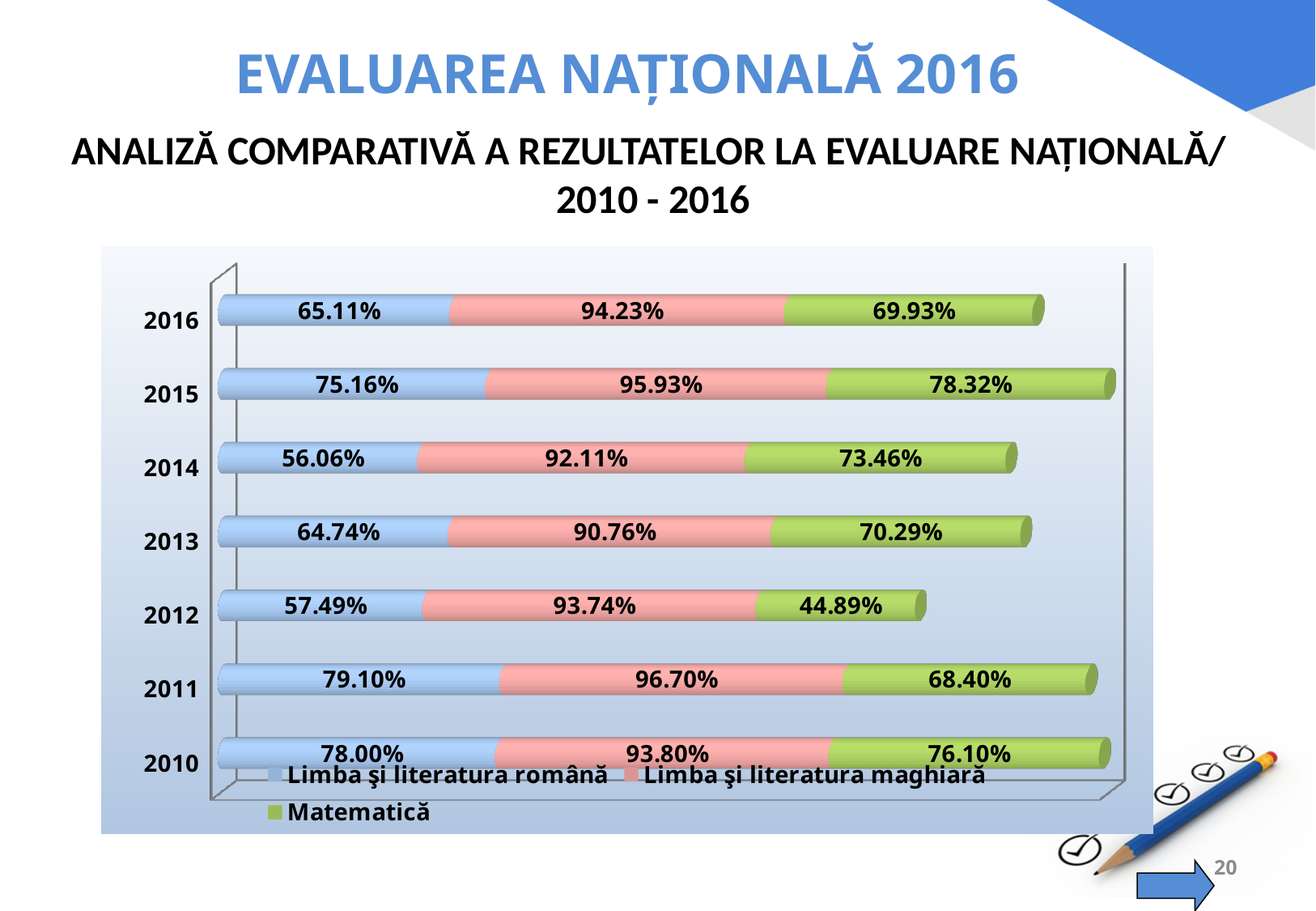
What kind of chart is shown on the slide? Stacked bar chart What is the value for Limba şi literatura română in 2016? 65.11% What is the value for Matematică in 2012? 44.89% What is the difference between Limba şi literatura maghiară and Limba şi literatura română in 2016? 29.12% In which year is the value for Limba şi literatura română the highest? 2011 In which year is the value for Matematică the lowest? 2012 Which series is shown in green? Matematică Which is larger in 2015: Limba şi literatura română or Matematică? Matematică What is the value for Limba şi literatura maghiară in 2014? 92.11% How many series does the legend list? 3 How many years are shown on the chart? 7 What is the total of the stacked bar for 2016? 229.27%